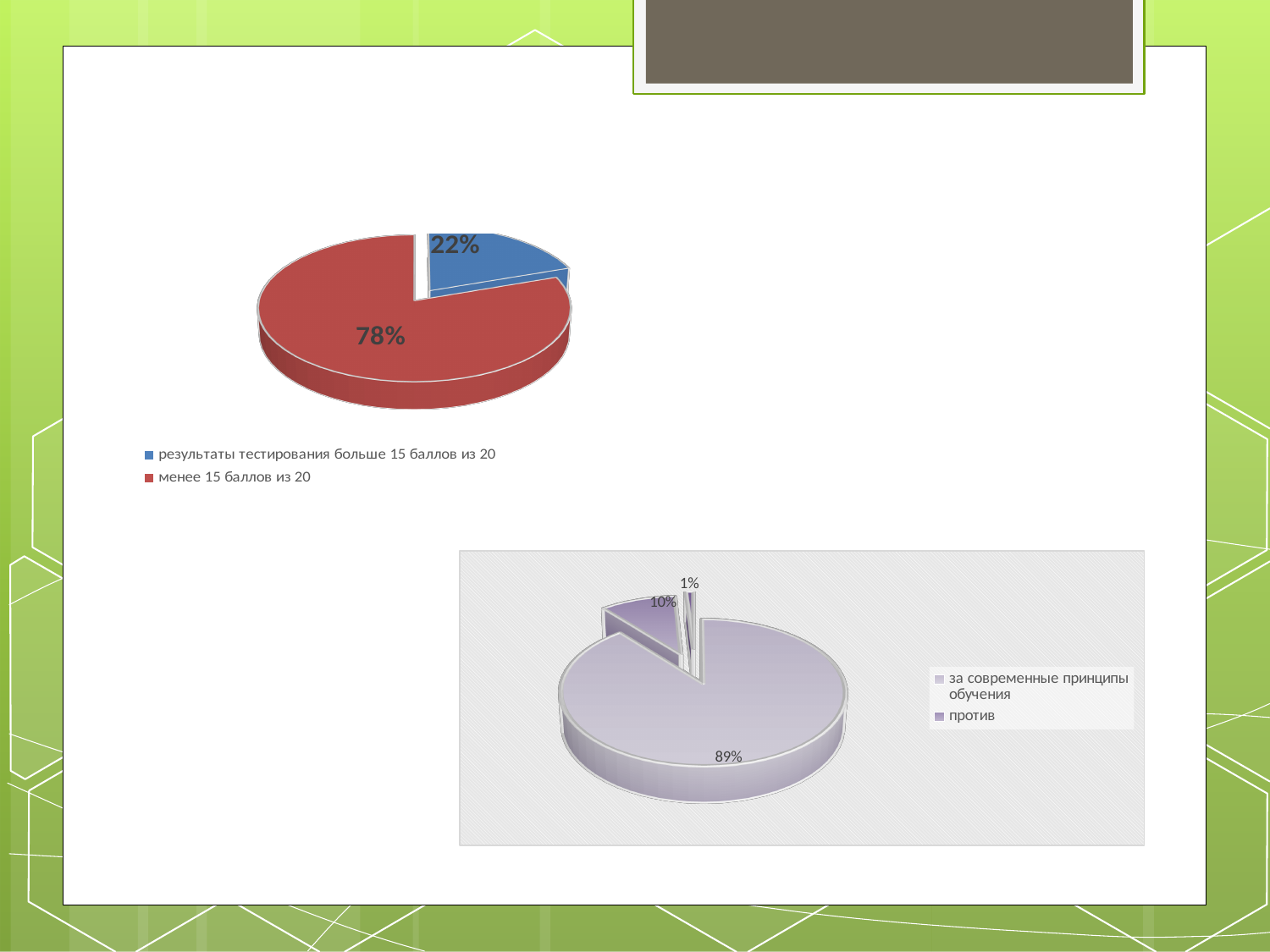
In the upper-left pie chart, what is the difference between the 78% slice and the 22% slice? 56% What kind of chart is the chart in the upper left of the slide? pie chart In the upper-left pie chart, what share is shown for 'менее 15 баллов из 20'? 78% What kind of chart is the chart in the lower right of the slide? pie chart In the lower-right pie chart, which is larger: the slice for 'за современные принципы обучения' or the slice for 'против'? за современные принципы обучения In the upper-left pie chart, which category has the largest slice? менее 15 баллов из 20 In the lower-right pie chart, what share is shown for 'за современные принципы обучения'? 89% In the lower-right pie chart, what share is shown for 'против'? 10% In the lower-right pie chart, how many slices are shown? 3 In the upper-left pie chart, how many entries does the legend list? 2 In the upper-left pie chart, what colour is the slice for 'менее 15 баллов из 20'? red